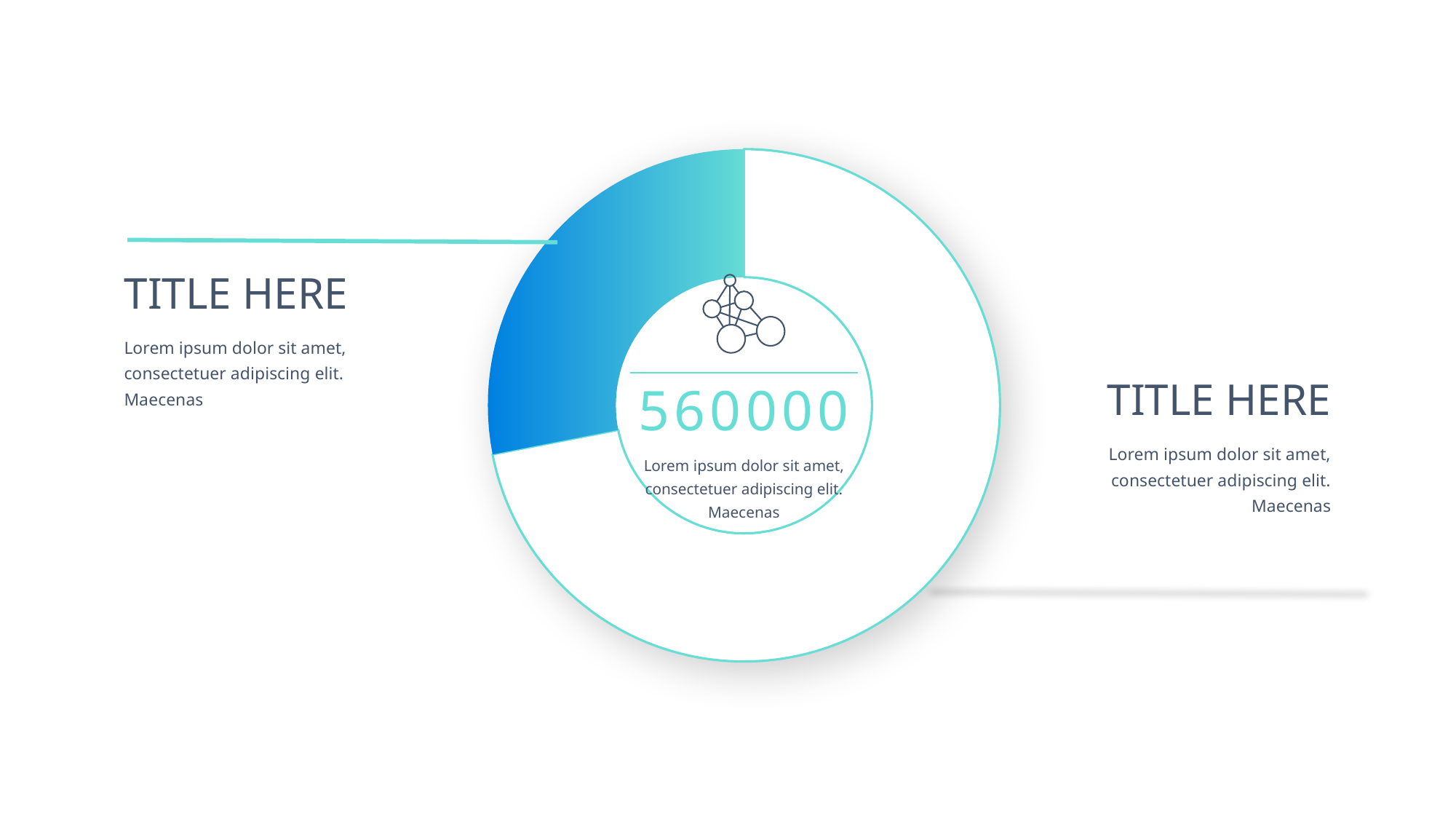
Which slice of the pie chart is the smallest? the blue slice What number is printed in the centre of the pie chart? 560000 Does the blue slice cover more or less than half of the pie chart? less Which slice of the pie chart is larger, the blue one or the white one? the white one What kind of chart is shown on the slide? doughnut chart What colour is the smaller slice of the pie chart? blue How many slices does the pie chart have? 2